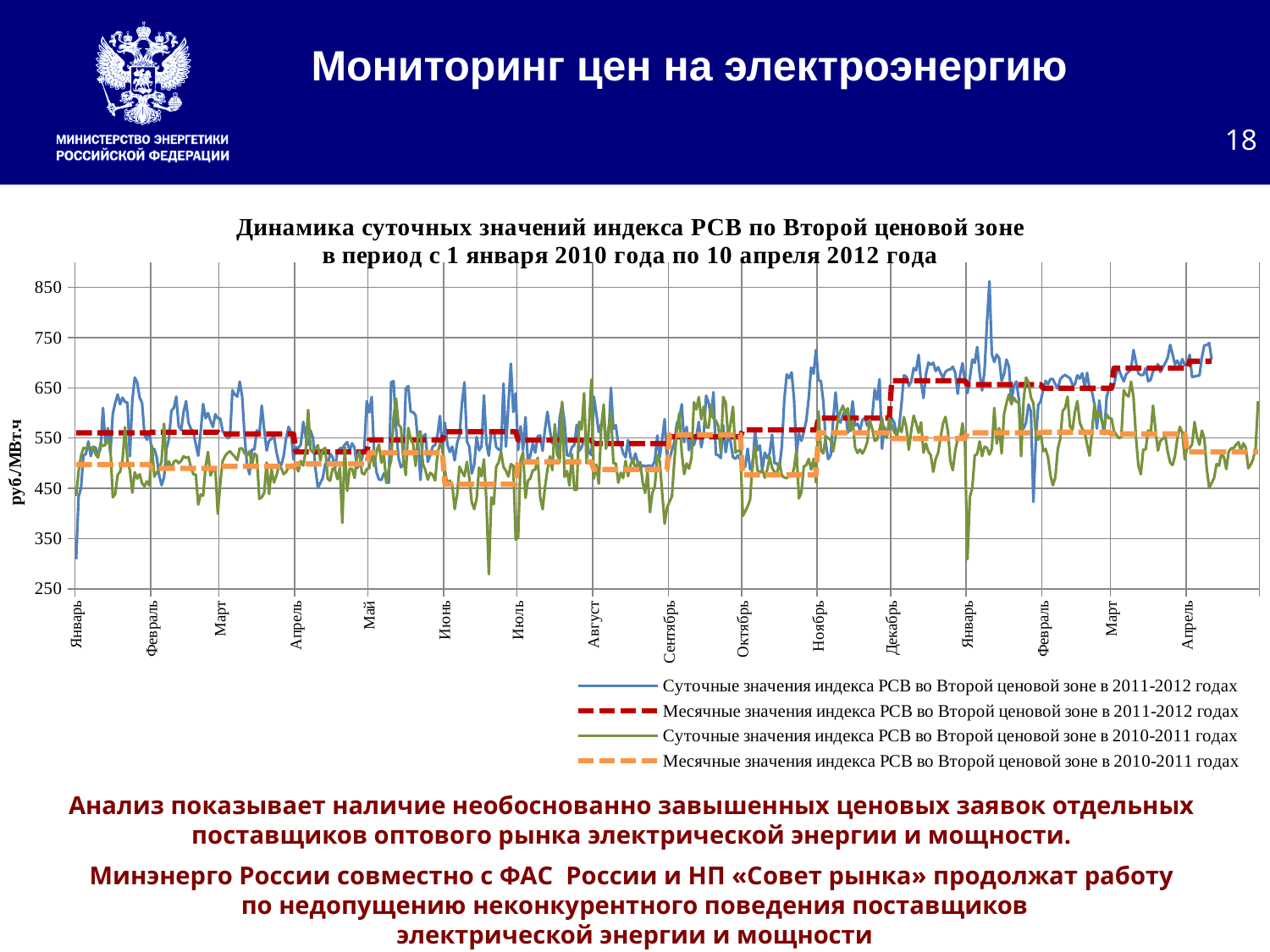
Is the monthly value of the РСВ index for 2011-2012 (red dashed line) in the second Март greater or less than 650? greater Does the highest daily value of the РСВ index for 2011-2012 (blue line) in the second Январь exceed 750? greater Does the monthly value of the РСВ index for 2011-2012 (red dashed line) generally rise or fall from the first Январь to the last Апрель? rise What is the title of the chart? Динамика суточных значений индекса РСВ по Второй ценовой зоне в период с 1 января 2010 года по 10 апреля 2012 года Is the monthly value of the РСВ index for 2011-2012 (red dashed line) in the first Январь greater or less than 650? less What is the label of the vertical axis? руб./МВт.ч How many month labels are shown along the x axis? 16 How many series does the legend list? 4 In Декабрь, which is higher: the monthly value for 2011-2012 (red dashed line) or the monthly value for 2010-2011 (orange dashed line)? Месячные значения индекса РСВ во Второй ценовой зоне в 2011-2012 годах What kind of chart is shown on the slide? line chart